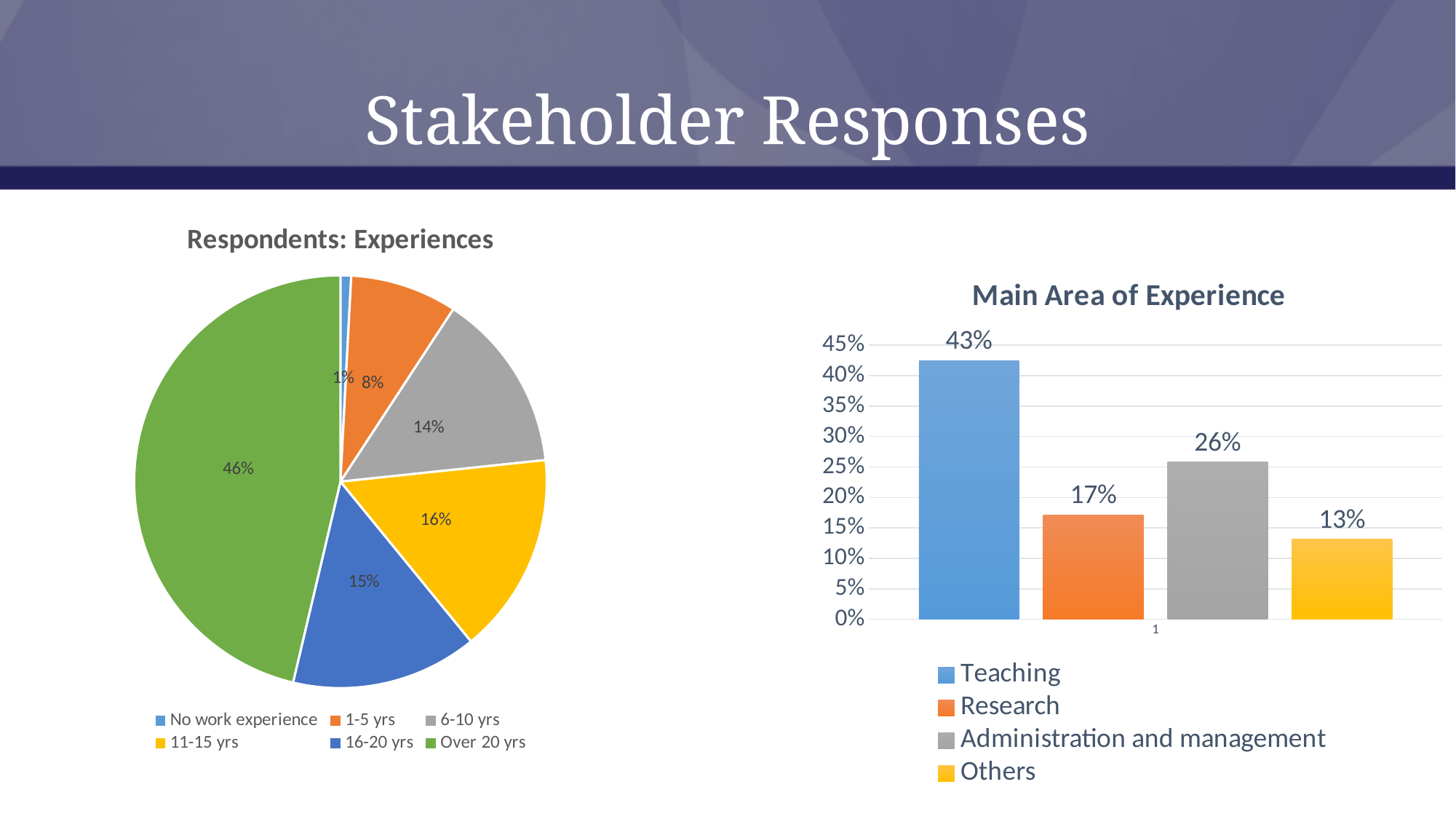
What kind of chart is 'Main Area of Experience'? Bar chart In the 'Respondents: Experiences' chart, what percentage of respondents have 6-10 years of experience? 14% In the 'Main Area of Experience' chart, what is the difference between Teaching and Administration and management? 17% In the 'Respondents: Experiences' chart, which category has the largest slice? Over 20 yrs What kind of chart is 'Respondents: Experiences'? Pie chart In the 'Respondents: Experiences' chart, what share of respondents have over 20 years of experience? 46% In the 'Main Area of Experience' chart, what is the value for Research? 17% In the 'Main Area of Experience' chart, which area has the highest value? Teaching In the 'Main Area of Experience' chart, which is larger: Research or Others? Research In the 'Respondents: Experiences' chart, which category has the smallest slice? No work experience In the 'Respondents: Experiences' chart, what is the difference between the 11-15 yrs and 16-20 yrs shares? 1% In the 'Respondents: Experiences' chart, how many categories does the legend list? 6